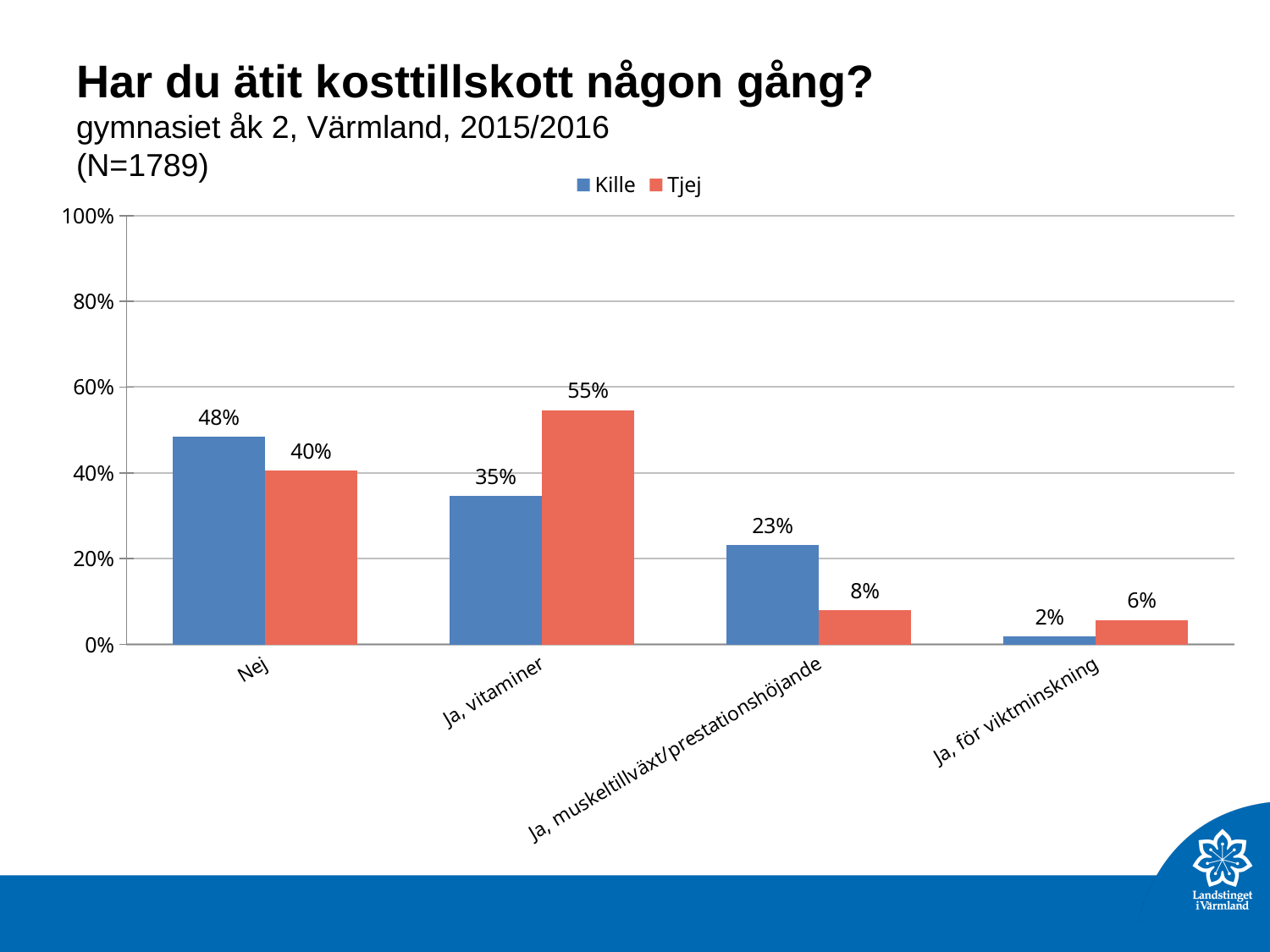
How many series does the legend list? 2 What is the difference between the Kille and Tjej values in the "Ja, muskeltillväxt/prestationshöjande" category? 15% What is the value for Kille in the "Ja, för viktminskning" category? 2% What is the value for Tjej in the "Ja, muskeltillväxt/prestationshöjande" category? 8% What kind of chart is shown on the slide? Bar chart How many categories are shown on the x axis? 4 Which category has the highest value for Tjej? Ja, vitaminer Is the value for Tjej in the "Ja, vitaminer" category greater or less than 40%? greater In the "Nej" category, which series has the larger value, Kille or Tjej? Kille Which category has the lowest value for Kille? Ja, för viktminskning What is the value for Kille in the "Nej" category? 48% What is the value for Tjej in the "Ja, vitaminer" category? 55%